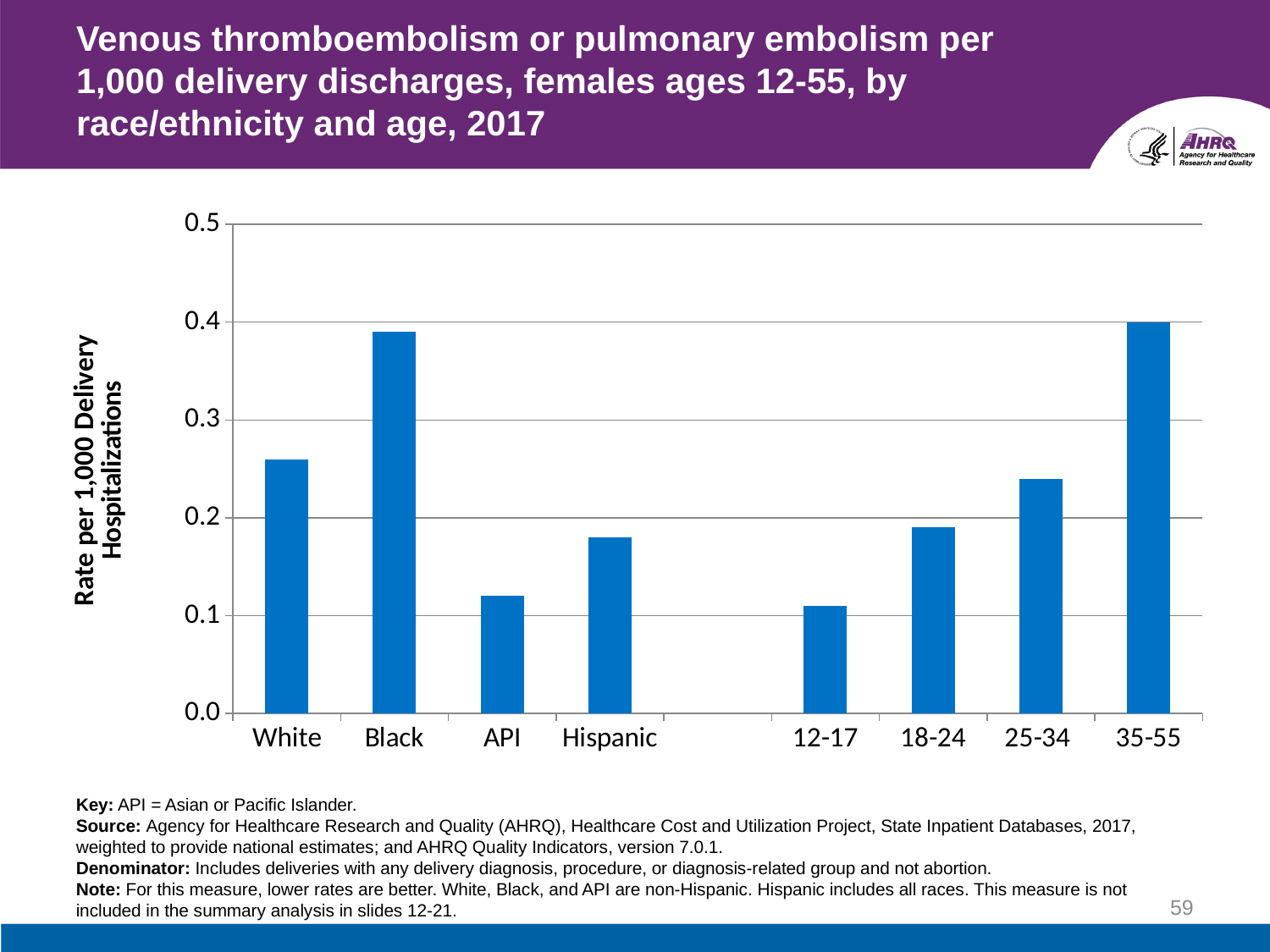
Among the age groups (12-17, 18-24, 25-34, 35-55), which has the highest rate? 35-55 Is the value for White greater or less than 0.2? greater Among the race/ethnicity groups (White, Black, API, Hispanic), which has the lowest rate? API Which has a higher rate, White or Hispanic? White Among the race/ethnicity groups (White, Black, API, Hispanic), which has the highest rate? Black Which has a higher rate, 18-24 or 25-34? 25-34 Is the value for Black greater or less than 0.3? greater What kind of chart is shown on the slide? Bar chart Is the value for Hispanic greater or less than 0.2? less How many bars are plotted in the chart? 8 Among the age groups (12-17, 18-24, 25-34, 35-55), which has the lowest rate? 12-17 What is the label on the vertical axis of the chart? Rate per 1,000 Delivery Hospitalizations